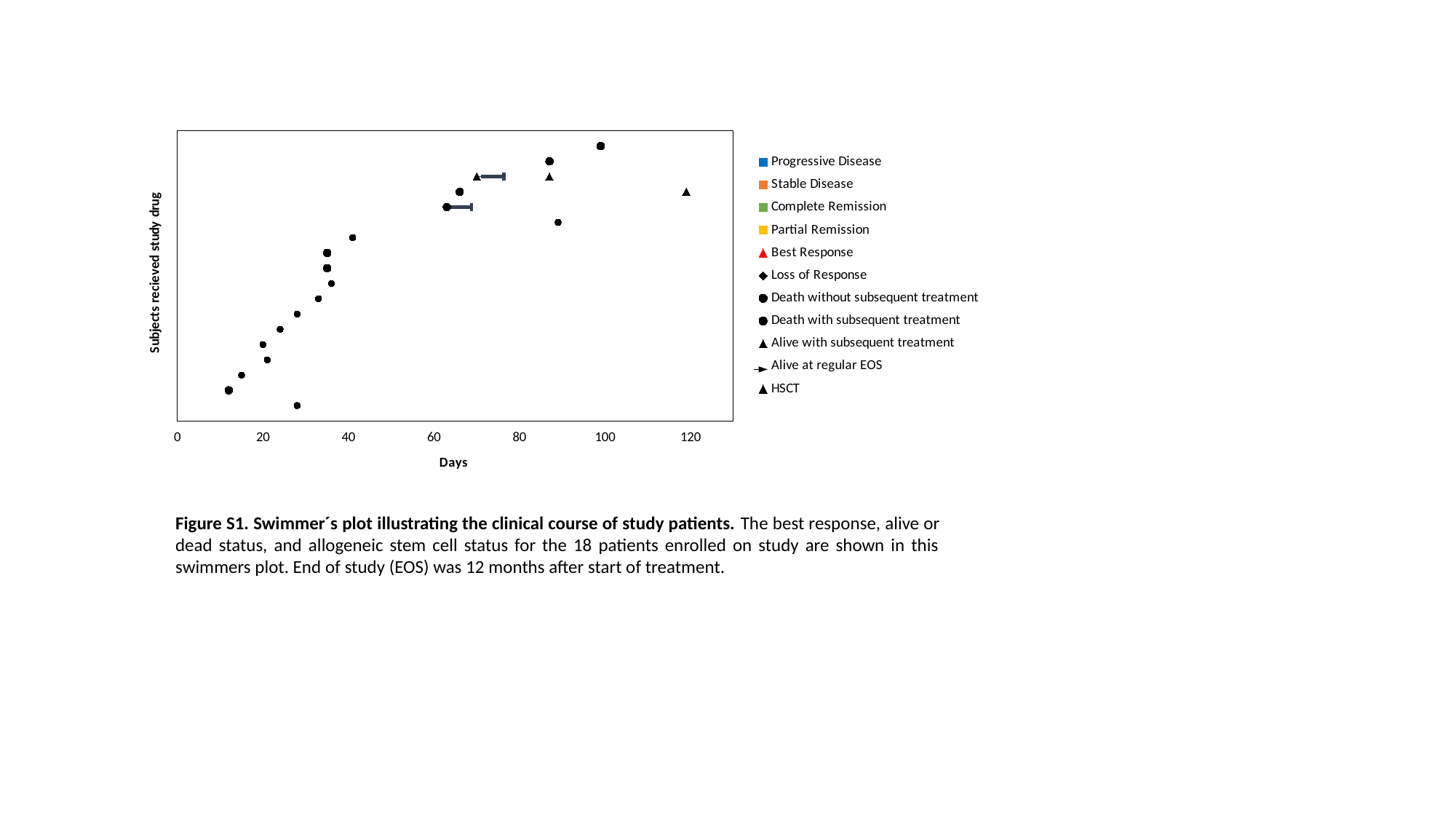
What is the title of the x axis of the chart? Days Do the markers on the chart generally move to higher day values as they go up the y axis? Yes, they rise Which marker lies furthest to the right on the chart, a circle or a triangle? A triangle Is the rightmost triangle marker on the chart at a value greater or less than 100 days? greater What is the largest tick value shown on the x axis of the chart? 120 How many entries does the legend of the chart list? 11 Is the topmost circle marker on the chart at a value greater or less than 80 days? greater Is the lowest marker on the chart (at the bottom of the plot) at a value greater or less than 40 days? less What is the title of the y axis of the chart? Subjects recieved study drug What kind of chart is shown on the slide? Scatter plot (swimmer's plot)